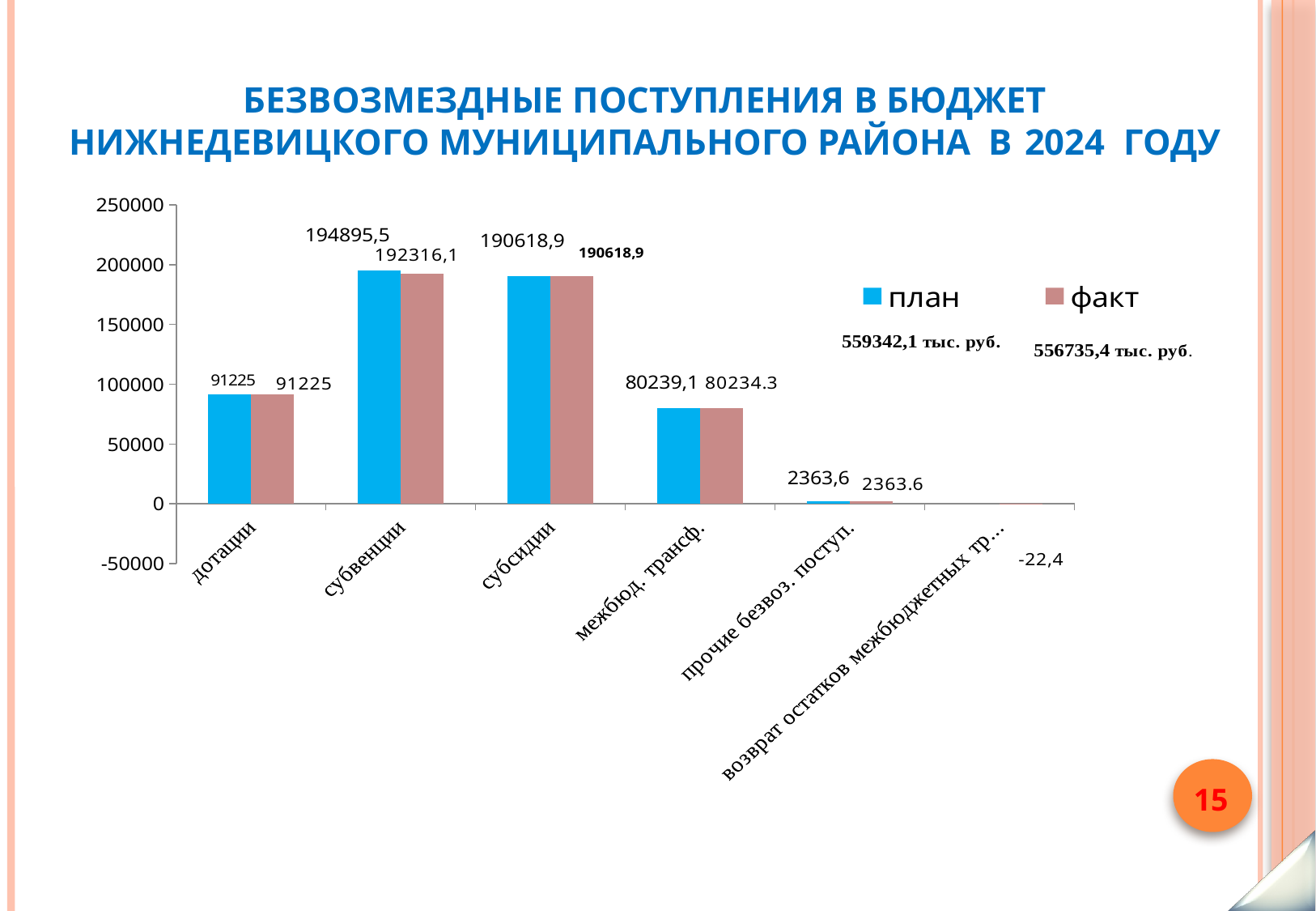
What is the value labelled for возврат остатков межбюджетных тр...? -22,4 What is the план value for дотации? 91225 What type of chart is shown on the slide? bar chart Which category has the highest план value? субвенции What is the difference between the план and факт values for субвенции? 2579,4 How many categories are shown on the x axis? 6 What is the факт value for субвенции? 192316,1 What is the факт value for межбюд. трансф.? 80234.3 Which is larger for субвенции, the план value or the факт value? план How many series does the legend list? 2 Which category has the lowest value on the chart? возврат остатков межбюджетных тр... What is the план value for субвенции? 194895,5